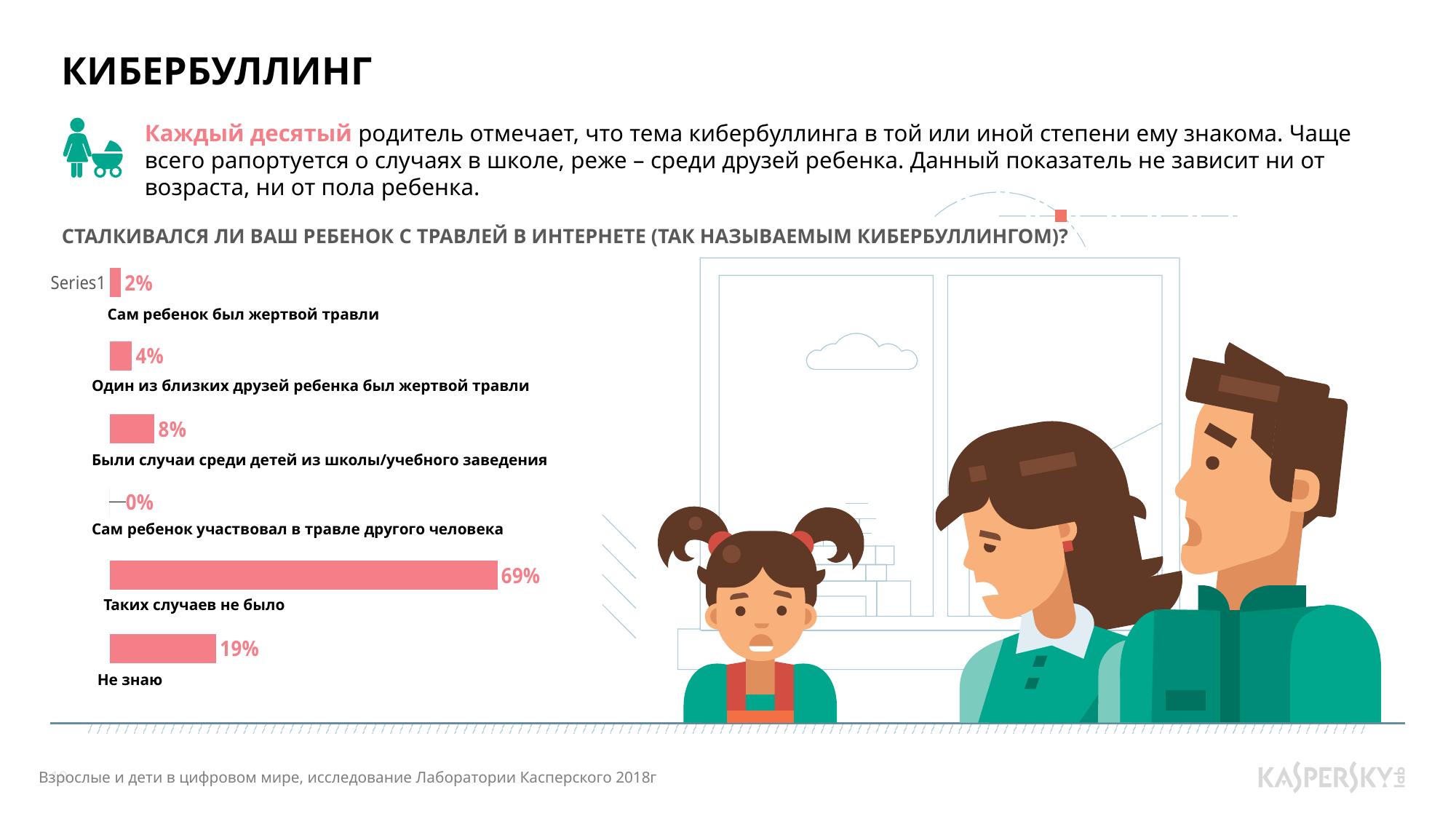
What is the difference between "Таких случаев не было" and "Не знаю"? 50% What percentage of parents answered "Таких случаев не было"? 69% What type of chart is used on the slide? Bar chart How many answer options are shown in the chart? 6 Which answer option has the highest value? Таких случаев не было What is the difference between "Были случаи среди детей из школы/учебного заведения" and "Один из близких друзей ребенка был жертвой травли"? 4% What percentage is shown for "Сам ребенок участвовал в травле другого человека"? 0% Which answer option has the lowest value? Сам ребенок участвовал в травле другого человека What percentage is shown for "Были случаи среди детей из школы/учебного заведения"? 8% What is the value for "Не знаю"? 19% What is the value for "Сам ребенок был жертвой травли"? 2% Which is larger: "Один из близких друзей ребенка был жертвой травли" or "Сам ребенок был жертвой травли"? Один из близких друзей ребенка был жертвой травли